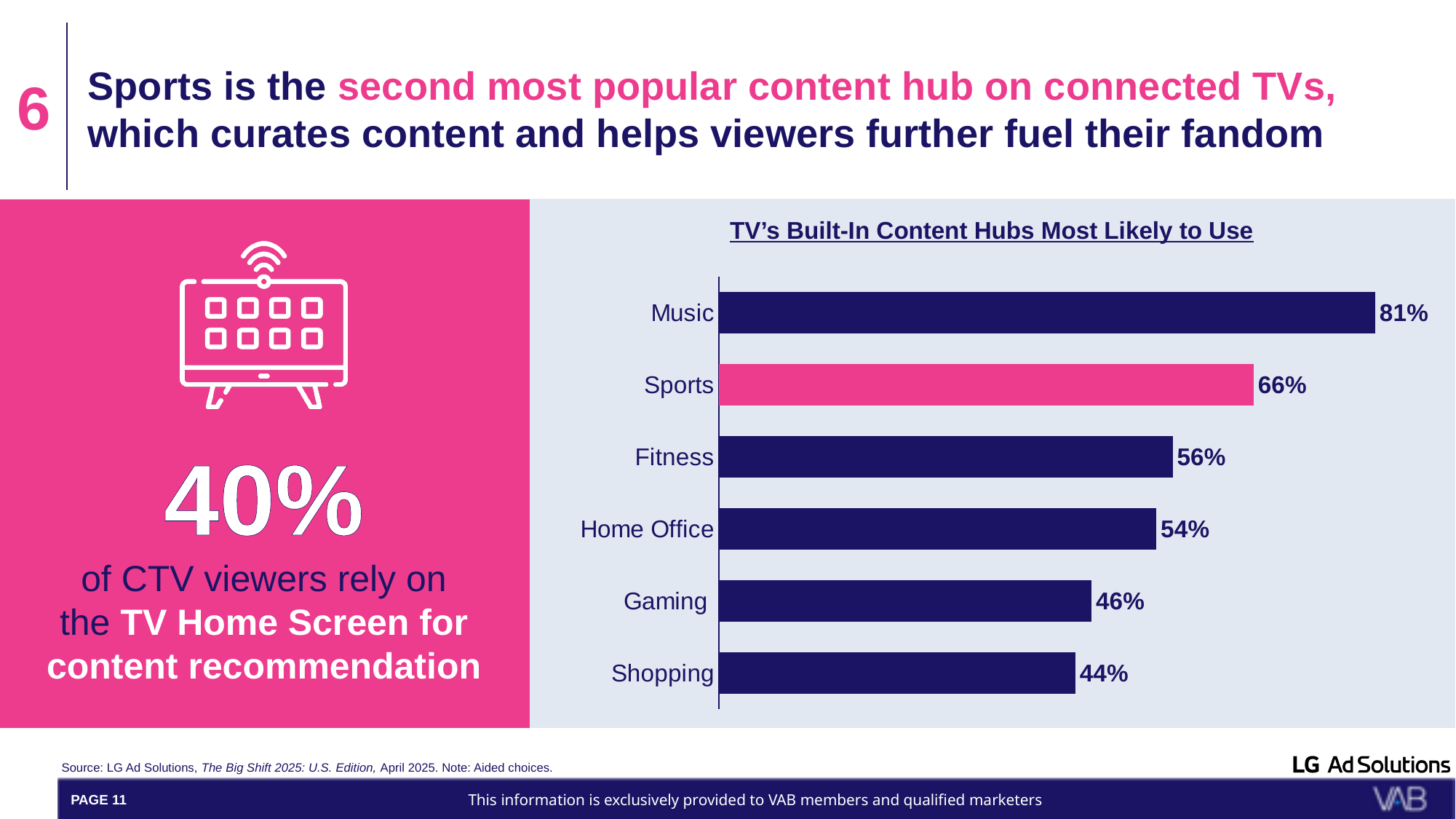
Which content hub has the lowest value in the chart? Shopping Which has a larger value, Fitness or Home Office? Fitness Which content hub has the highest value in the chart? Music How many content hubs are shown in the chart? 6 What is the value for Home Office in the chart? 54% What kind of chart is shown on the slide? Bar chart What is the title of the chart? TV's Built-In Content Hubs Most Likely to Use What is the value for Sports in the chart? 66% What is the difference between the values for Music and Sports? 15% What is the value for Music in the chart? 81% What is the value for Shopping in the chart? 44% What is the difference between the values for Fitness and Gaming? 10%